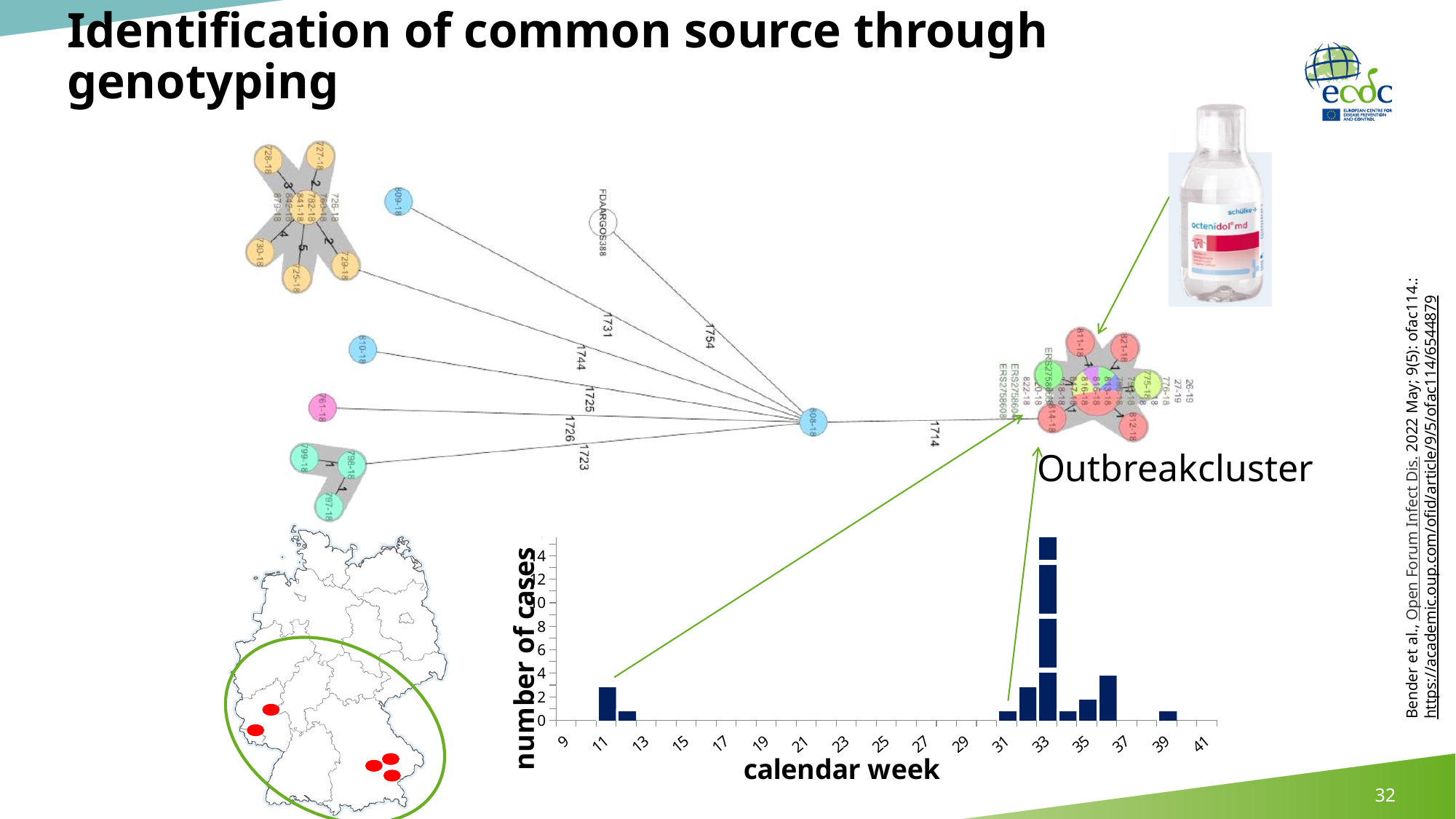
What kind of chart is shown at the bottom of the slide? bar chart What is the label of the y axis of the bar chart? number of cases In the bar chart, which has more cases: calendar week 11 or calendar week 12? calendar week 11 In the bar chart, is the number of cases in calendar week 33 greater or less than 10? greater How many calendar weeks have a bar (at least one case) in the bar chart? 9 In the bar chart, which calendar week has the highest number of cases? 33 In the bar chart, is the number of cases in calendar week 36 greater or less than 2? greater In the bar chart, is the number of cases in calendar week 12 greater or less than 2? less What is the label of the x axis of the bar chart? calendar week In the bar chart, which has more cases: calendar week 33 or calendar week 36? calendar week 33